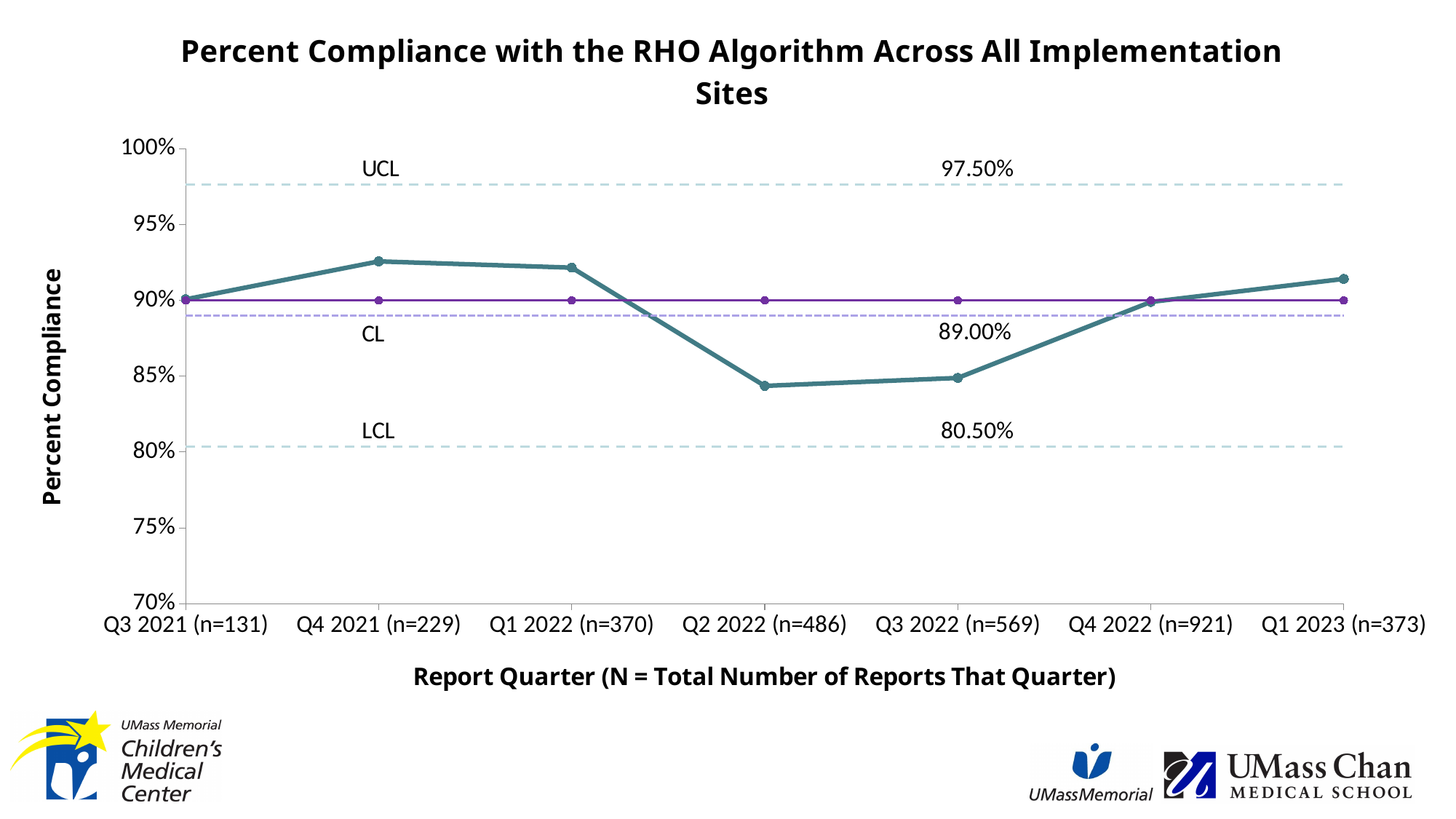
Does percent compliance rise or fall from Q1 2022 to Q2 2022? fall Is the percent compliance for Q1 2023 greater or less than 90%? greater What is the value of the lower control limit (LCL) shown on the chart? 80.50% What kind of chart is shown on the slide? line chart Which quarter has the higher percent compliance, Q4 2021 or Q2 2022? Q4 2021 How many report quarters are plotted along the x axis? 7 What is the value of the upper control limit (UCL) shown on the chart? 97.50% What is the difference between the UCL and the LCL values? 17.00% Is the percent compliance for Q2 2022 greater or less than 85%? less What is the title of the chart? Percent Compliance with the RHO Algorithm Across All Implementation Sites Is the percent compliance for Q4 2021 greater or less than 90%? greater What is the value of the center line (CL) shown on the chart? 89.00%